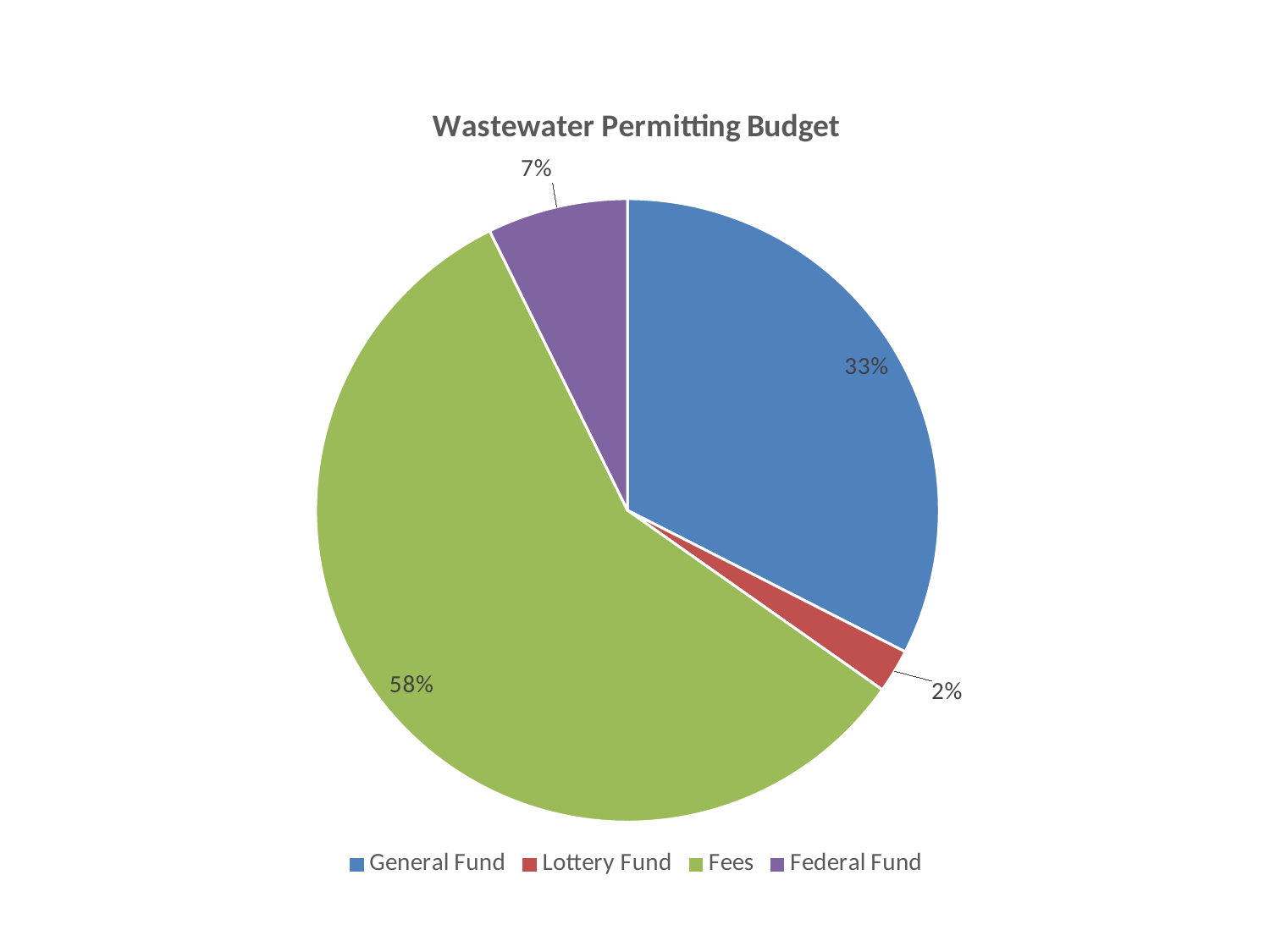
Which funding source makes up the smallest share of the Wastewater Permitting Budget? Lottery Fund Which is larger, the Federal Fund share or the Lottery Fund share? Federal Fund Which funding source makes up the largest share of the Wastewater Permitting Budget? Fees What share of the Wastewater Permitting Budget comes from Fees? 58% What kind of chart is shown on the slide? Pie chart What is the title of the chart? Wastewater Permitting Budget How many funding sources are shown in the pie chart? 4 What share of the Wastewater Permitting Budget comes from the Lottery Fund? 2% What colour represents Fees in the pie chart? Green What is the difference in percentage points between the Fees share and the General Fund share? 25 What share of the Wastewater Permitting Budget comes from the Federal Fund? 7%